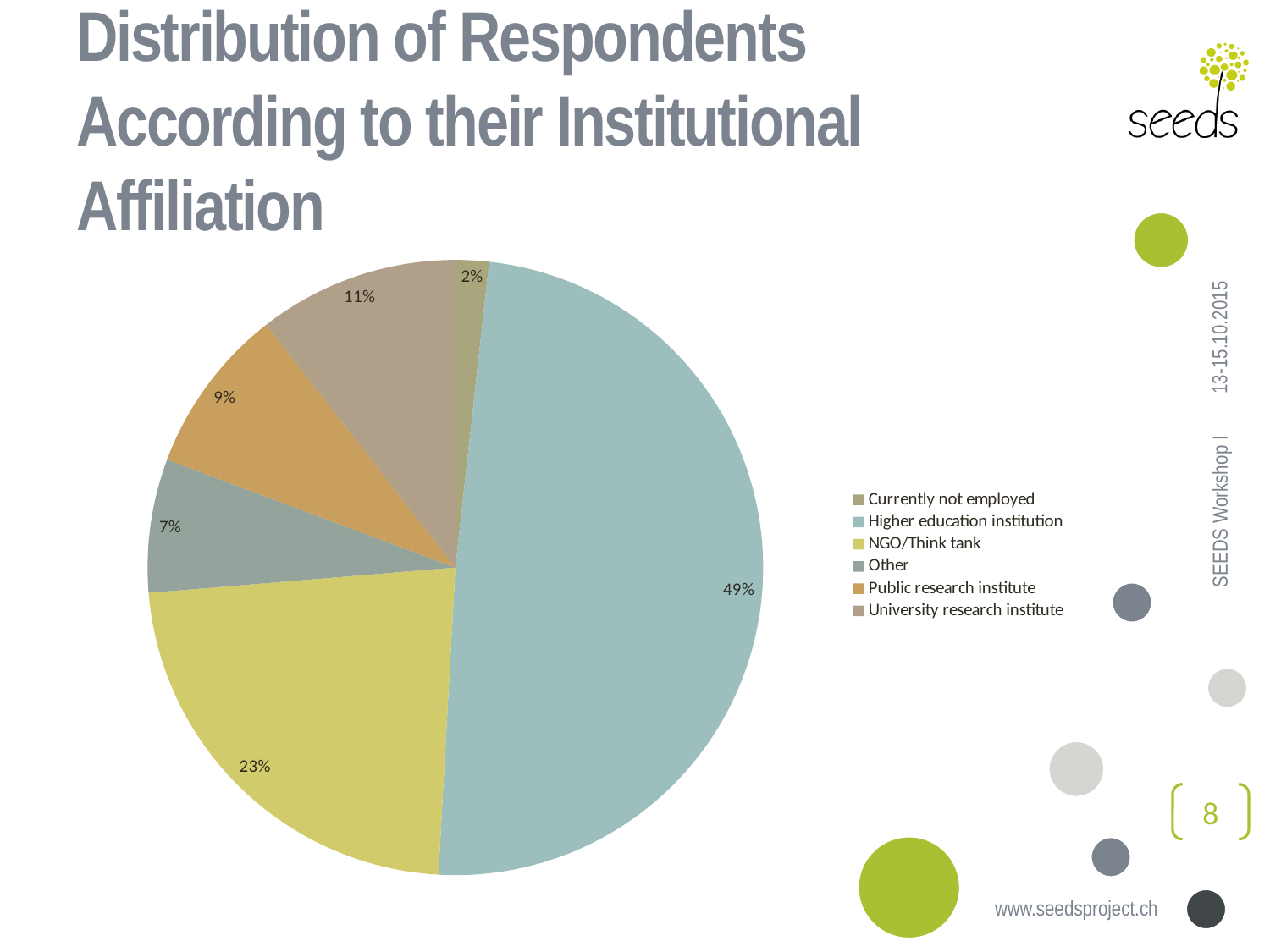
What share of respondents are from a higher education institution? 49% Which institutional affiliation has the largest share of respondents? Higher education institution Which institutional affiliation has the smallest share of respondents? Currently not employed Which has a larger share of respondents, Public research institute or Other? Public research institute What percentage of respondents are from an NGO/Think tank? 23% What is the combined share of respondents from Other and Public research institute? 16% What share of respondents are currently not employed? 2% What share of respondents are from a university research institute? 11% What type of chart is shown on the slide? Pie chart What percentage of respondents are from a public research institute? 9% How many categories does the pie chart show? 6 What is the difference in percentage points between the Higher education institution and NGO/Think tank shares? 26